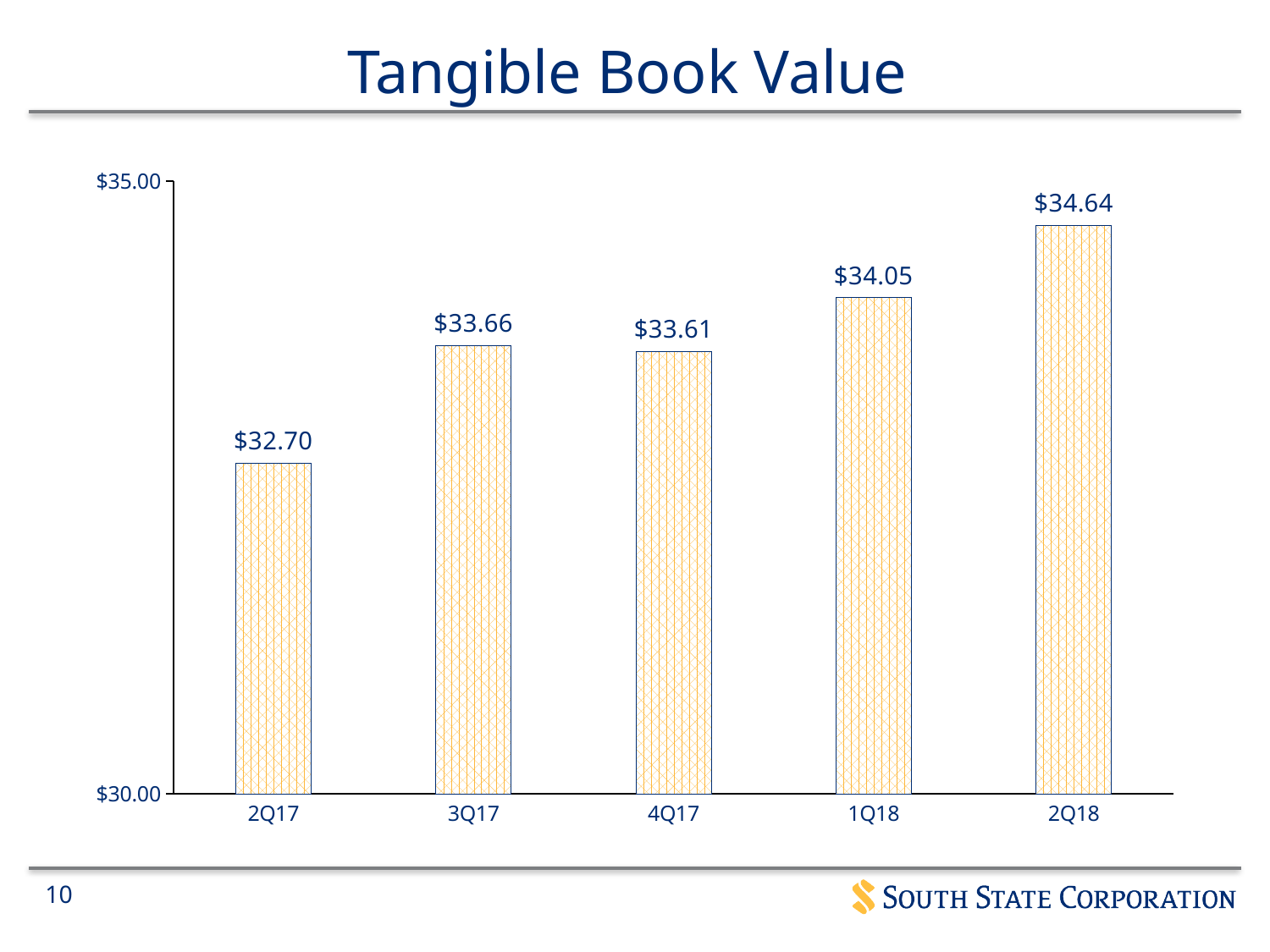
What kind of chart is shown on the slide? Bar chart What is the tangible book value for 2Q18? $34.64 Which is larger, the tangible book value for 3Q17 or for 1Q18? 1Q18 Does the tangible book value generally rise or fall from 2Q17 to 2Q18? Rise Which quarter has the lowest tangible book value? 2Q17 What is the title of the chart? Tangible Book Value What is the difference in tangible book value between 2Q18 and 2Q17? $1.94 What is the difference in tangible book value between 1Q18 and 4Q17? $0.44 What is the tangible book value for 4Q17? $33.61 Which quarter has the highest tangible book value? 2Q18 How many quarters are shown on the chart? 5 What is the tangible book value for 2Q17? $32.70